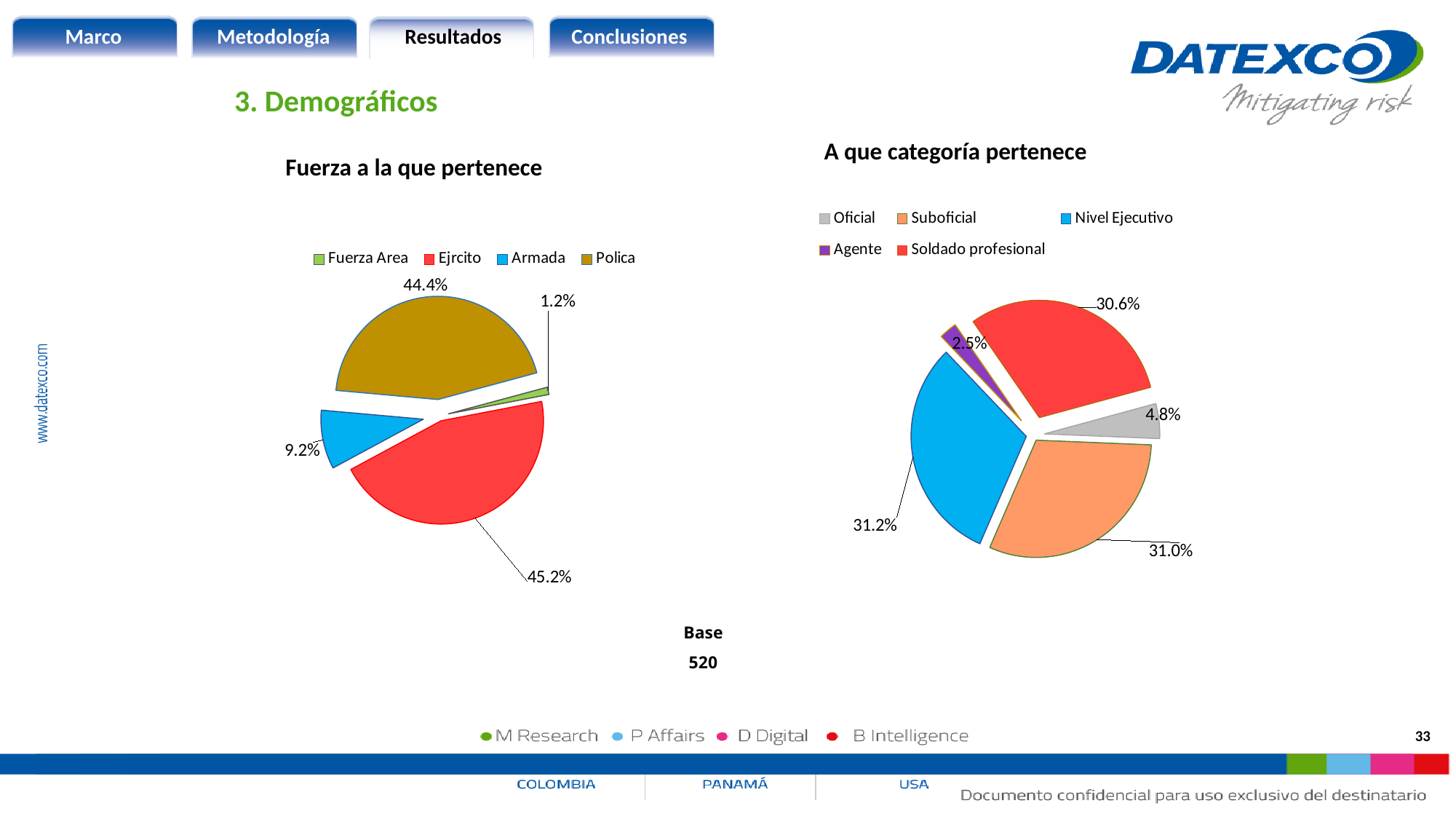
What type of chart is 'Fuerza a la que pertenece'? Pie chart In the 'A que categoría pertenece' chart, which is larger: Oficial or Suboficial? Suboficial In the 'Fuerza a la que pertenece' chart, what percentage is shown for Ejrcito? 45.2% In the 'A que categoría pertenece' chart, which category has the smallest share? Agente In the 'A que categoría pertenece' chart, what percentage is shown for Agente? 2.5% In the 'Fuerza a la que pertenece' chart, how many categories does the legend list? 4 In the 'Fuerza a la que pertenece' chart, what percentage is shown for Armada? 9.2% In the 'A que categoría pertenece' chart, what percentage is shown for Soldado profesional? 30.6% In the 'A que categoría pertenece' chart, what colour is the Nivel Ejecutivo slice? Blue In the 'Fuerza a la que pertenece' chart, what is the difference between the Polica and Armada shares? 35.2% In the 'A que categoría pertenece' chart, how many categories does the legend list? 5 In the 'Fuerza a la que pertenece' chart, which category has the smallest share? Fuerza Area